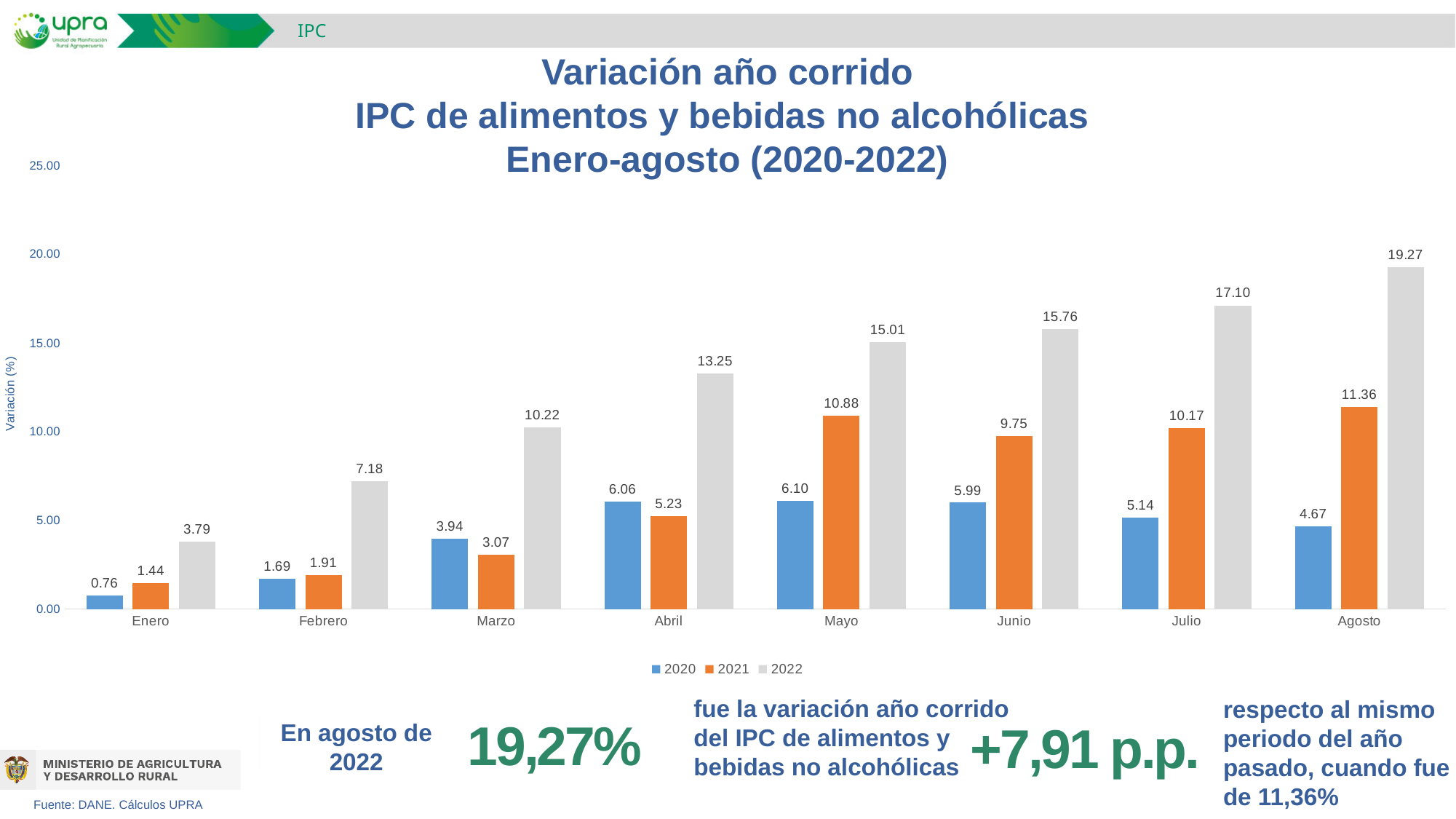
Do the values for the 2022 series rise or fall from Enero to Agosto? Rise What is the value for 2021 in Marzo? 3.07 What kind of chart is shown on the slide? Bar chart Which month has the highest value for the 2021 series? Agosto What is the difference between the 2022 and 2021 values in Agosto? 7.91 How many months are shown on the x axis? 8 Which month has the lowest value for the 2020 series? Enero Which is larger in Abril: the 2020 value or the 2021 value? 2020 How many series does the legend list? 3 What is the label of the y axis? Variación (%) What is the value for 2020 in Mayo? 6.10 What is the value for 2022 in Agosto? 19.27